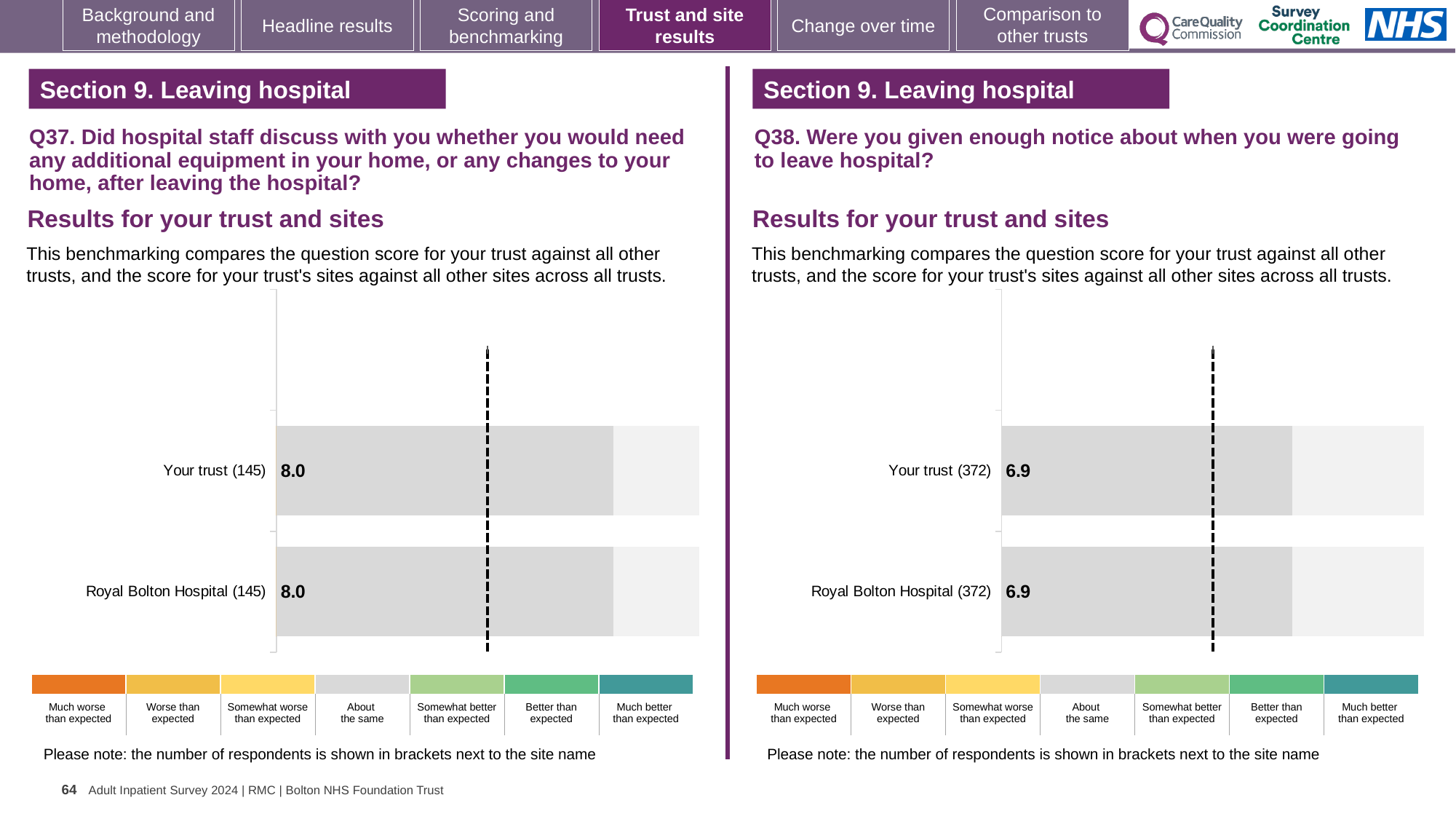
On the Q37 chart (left), how many respondents are shown in brackets next to Royal Bolton Hospital? 145 On the Q38 chart (right), what is the score for Your trust? 6.9 On the Q38 chart (right), what is the score for Royal Bolton Hospital? 6.9 On the Q38 chart (right), what is the difference between the score for Your trust and the score for Royal Bolton Hospital? 0.0 On the Q37 chart (left), what is the difference between the score for Your trust and the score for Royal Bolton Hospital? 0.0 On the Q37 chart (left), what is the score for Your trust? 8.0 What kind of chart is the Q38 chart (right)? Bar chart On the Q38 chart (right), how many respondents are shown in brackets next to Your trust? 372 On the Q37 chart (left), which benchmark category does the grey colour of the bars correspond to in the legend? About the same How many bars are plotted on the Q38 chart (right)? 2 How many bars are plotted on the Q37 chart (left)? 2 On the Q37 chart (left), what is the score for Royal Bolton Hospital? 8.0